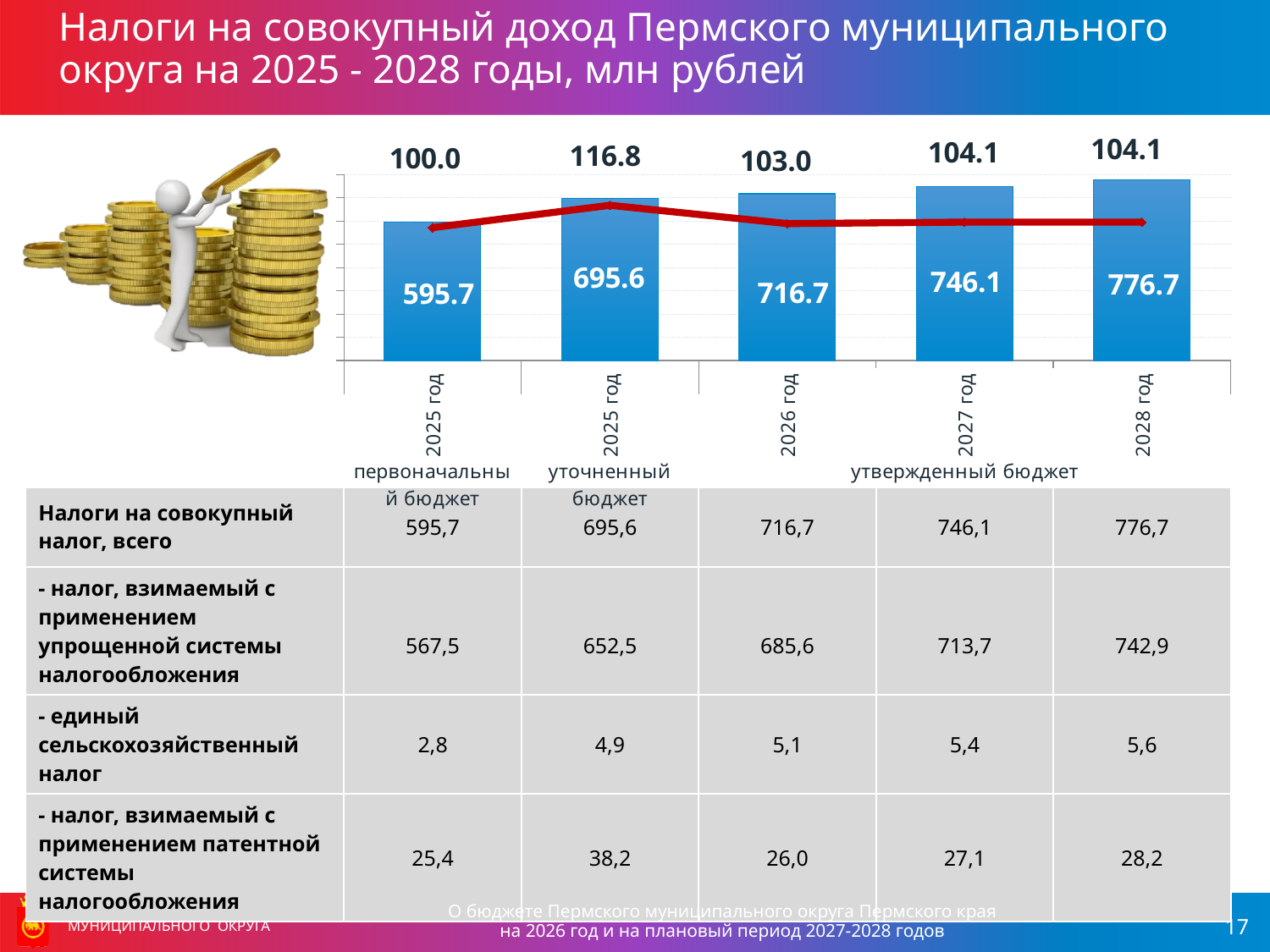
Which category has the lowest bar value? 2025 год (первоначальный бюджет) What is the bar value for 2028 год? 776.7 How many bars are plotted in the chart? 5 What kind of chart is shown on the slide? bar chart with a line Do the bar values rise or fall from left to right along the x axis? rise What is the line value shown above the 2025 год уточненный бюджет bar? 116.8 What is the difference between the bar values for 2028 год and 2027 год? 30.6 Which category has the highest bar value? 2028 год Which is larger, the bar value for 2026 год or for 2027 год? 2027 год What is the bar value for 2026 год? 716.7 What is the line value shown above the 2027 год bar? 104.1 What is the difference between the bar values for 2025 год уточненный бюджет and 2025 год первоначальный бюджет? 99.9